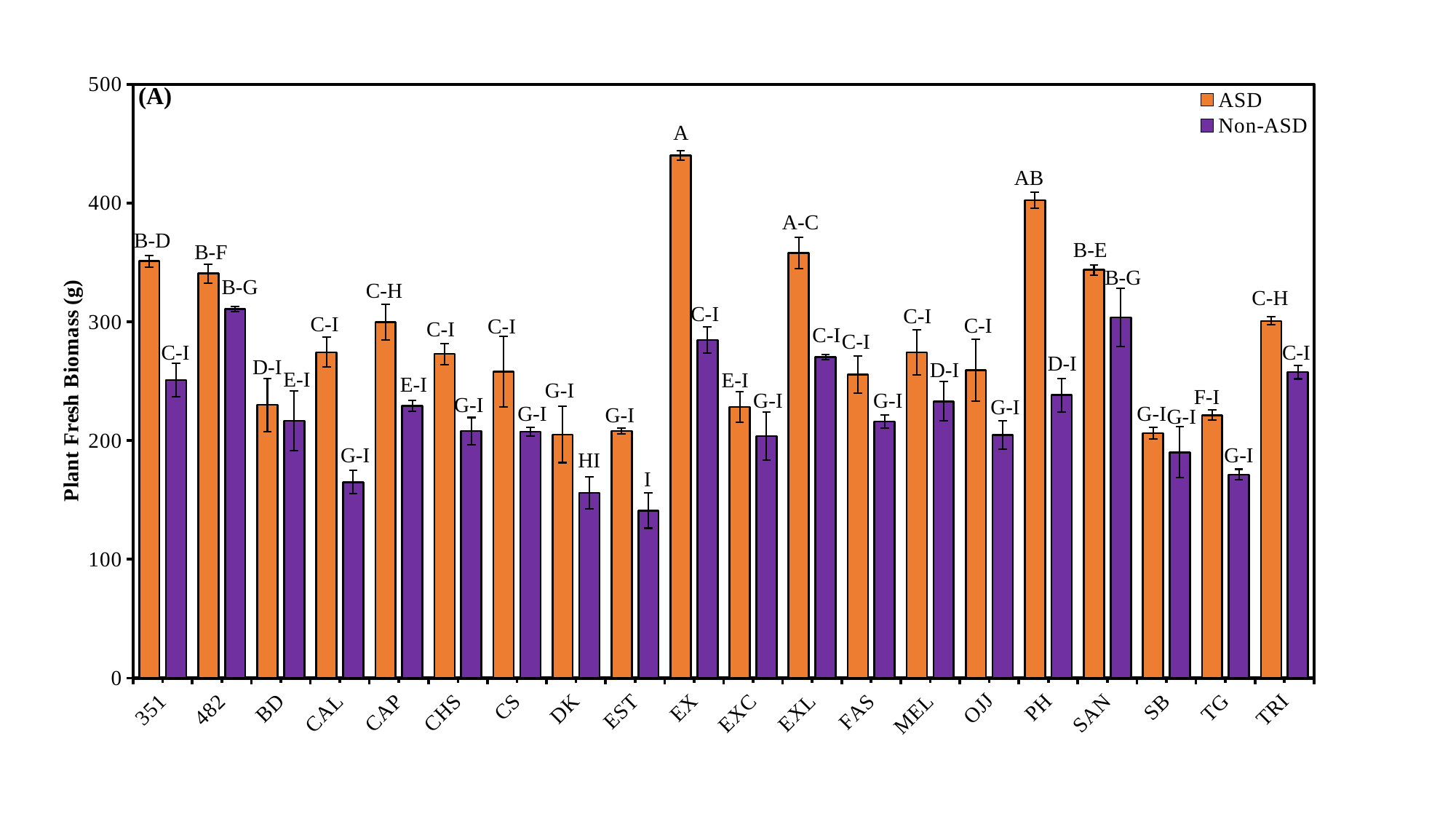
What is the y-axis title of the chart? Plant Fresh Biomass (g) Which category has the highest ASD plant fresh biomass? EX Which colour represents the Non-ASD series in the legend? purple Is the ASD value for SAN greater or less than 300? greater How many categories are shown along the x axis? 20 Is the ASD value for EX greater or less than 400? greater For category 482, which is larger: the ASD value or the Non-ASD value? ASD How many series does the legend list? 2 Is the Non-ASD value for CAL greater or less than 200? less Which is larger: the ASD value for EX or the ASD value for PH? EX Which category has the lowest Non-ASD plant fresh biomass? EST What kind of chart is shown on the slide? bar chart